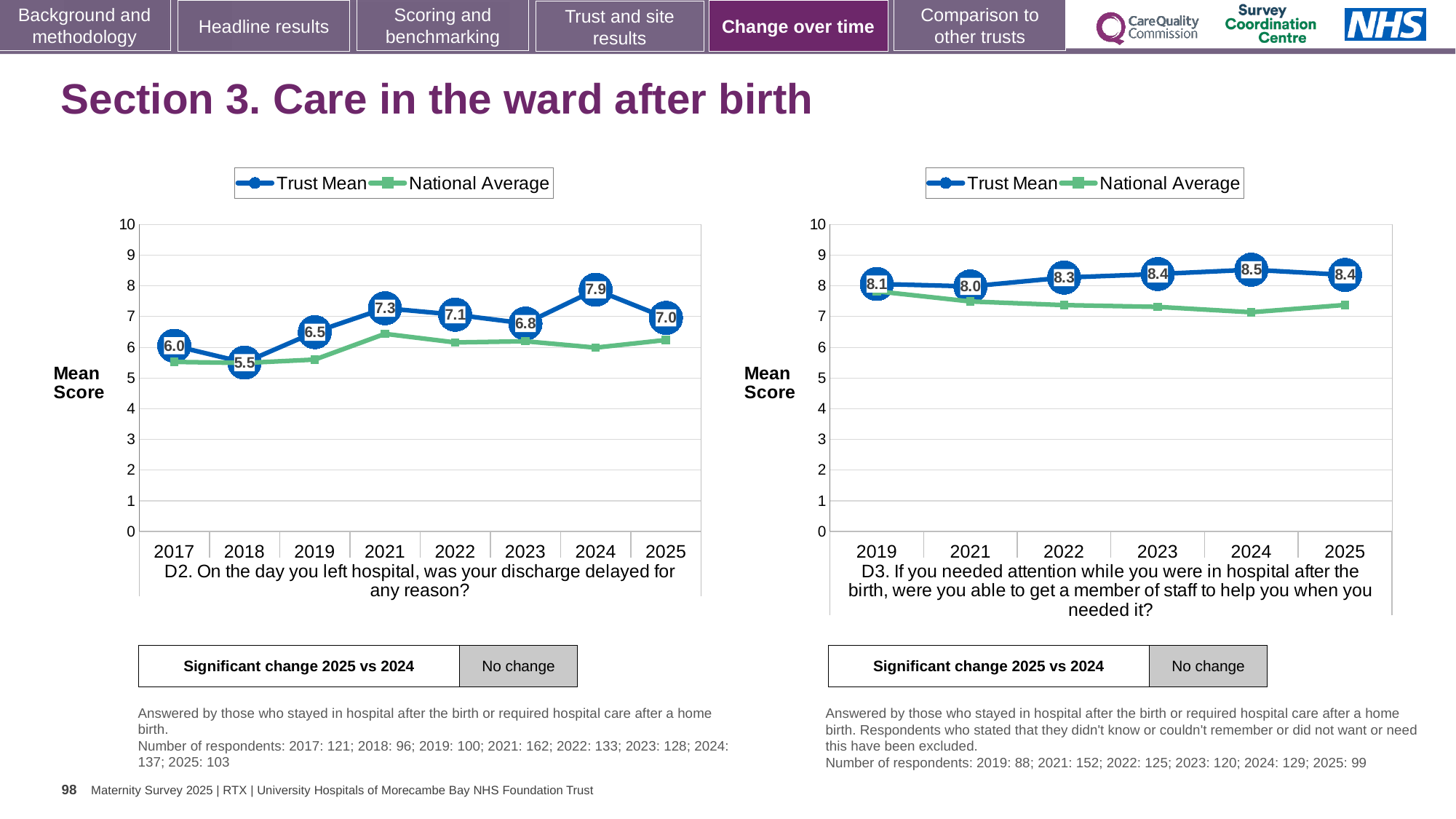
What type of chart is the left chart (D2)? Line chart In the right chart (D3), which year has the highest Trust Mean score? 2024 In the left chart (D2), what is the Trust Mean score for 2018? 5.5 In the left chart (D2), what is the difference between the Trust Mean scores for 2024 and 2025? 0.9 How many series does the legend of the right chart (D3) list? 2 In the left chart (D2), what is the Trust Mean score for 2024? 7.9 In the right chart (D3), is the National Average value for 2024 greater or less than 8? less In the right chart (D3), is the Trust Mean score for 2021 greater or less than the Trust Mean score for 2022? less In the right chart (D3), what is the Trust Mean score for 2025? 8.4 In the left chart (D2), how many years are shown on the x axis? 8 In the left chart (D2), which year has the highest Trust Mean score? 2024 In the left chart (D2), which year has the lowest Trust Mean score? 2018